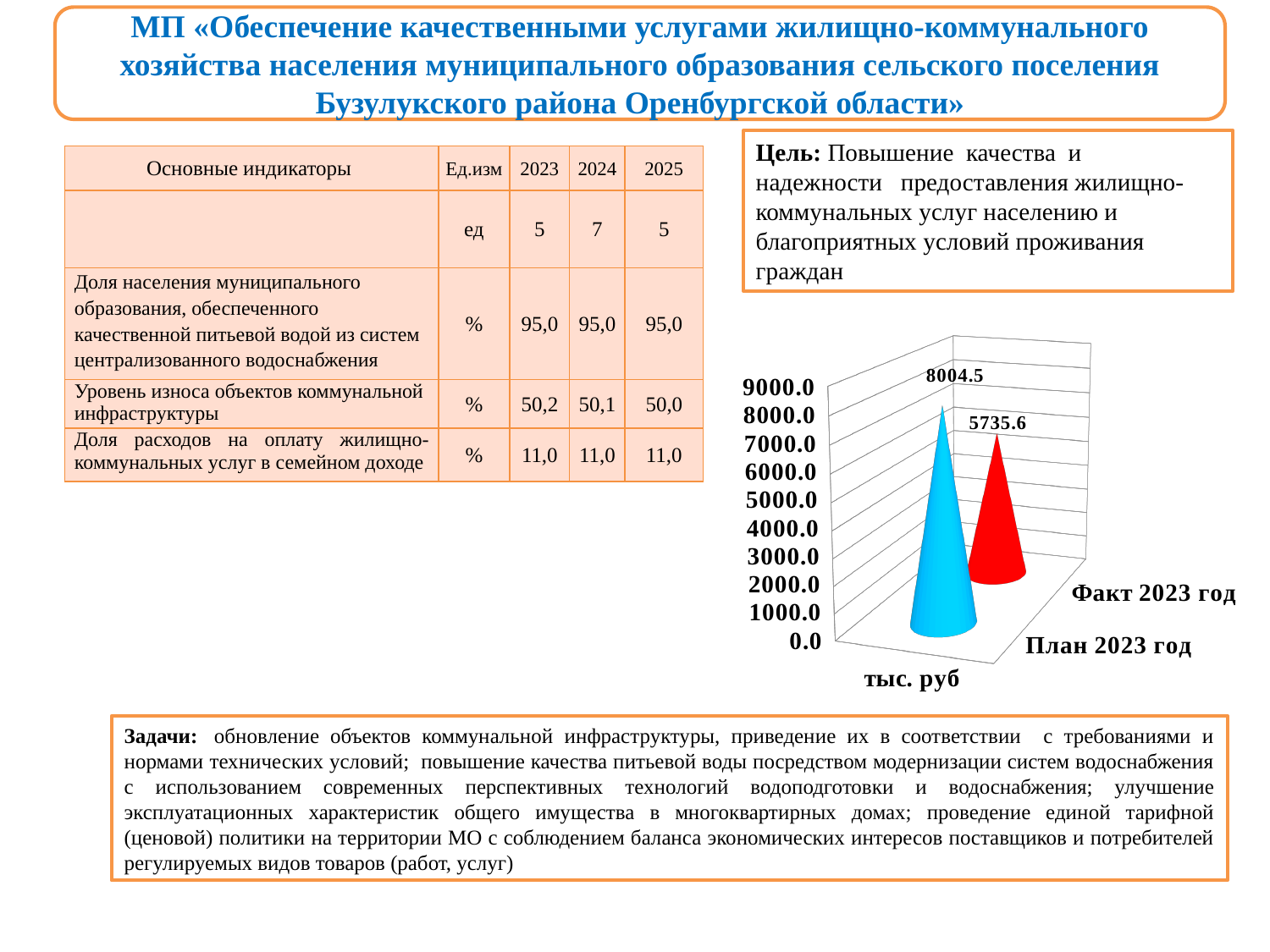
Is the value for Факт 2023 год greater or less than 6000.0? less What is the value for План 2023 год in the chart? 8004.5 Is the value for План 2023 год greater or less than 7000.0? greater Which category has the highest value in the chart? План 2023 год How many categories are plotted in the chart? 2 Which category has the higher value in the chart, План 2023 год or Факт 2023 год? План 2023 год What is the maximum value shown on the chart's vertical axis? 9000.0 What is the difference between the values for План 2023 год and Факт 2023 год? 2268.9 What is the value for Факт 2023 год in the chart? 5735.6 Which category has the lowest value in the chart? Факт 2023 год What unit is shown on the chart's axis label? тыс. руб What kind of chart is shown on the slide? bar chart